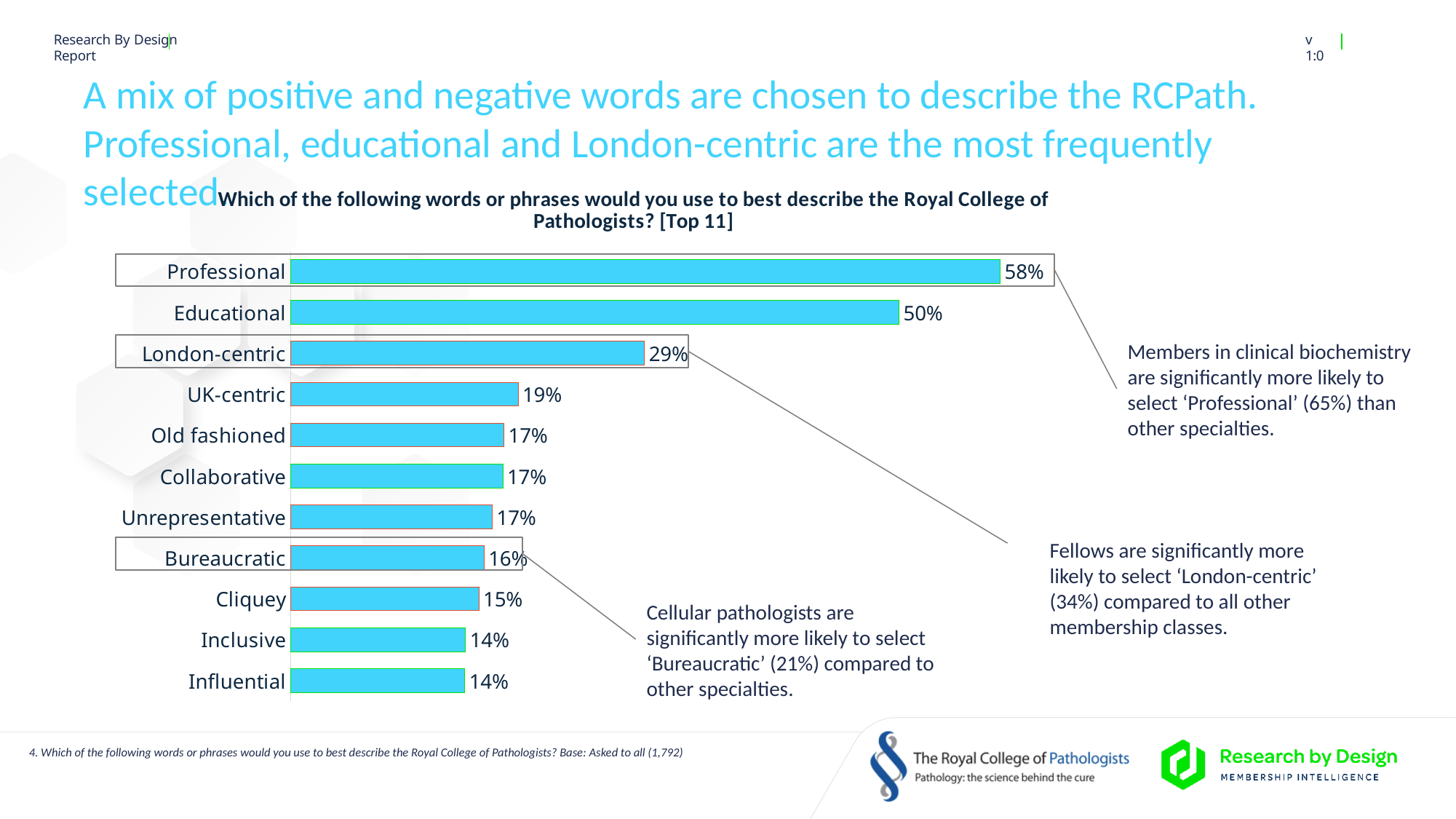
Which has a higher value, 'Bureaucratic' or 'Cliquey'? Bureaucratic Which has a higher value, 'Educational' or 'London-centric'? Educational What is the difference in percentage points between 'Professional' and 'Educational'? 8 What is the title of the chart? Which of the following words or phrases would you use to best describe the Royal College of Pathologists? [Top 11] How many categories share the value 17%? 3 Which word or phrase has the highest percentage in the chart? Professional What percentage is shown for 'Cliquey'? 15% What is the difference between the values for 'London-centric' and 'UK-centric'? 10 What is the value shown for 'London-centric'? 29% What percentage of respondents selected 'Professional' to describe the Royal College of Pathologists? 58% What type of chart is used on this slide? Bar chart How many words or phrases are shown in the chart? 11